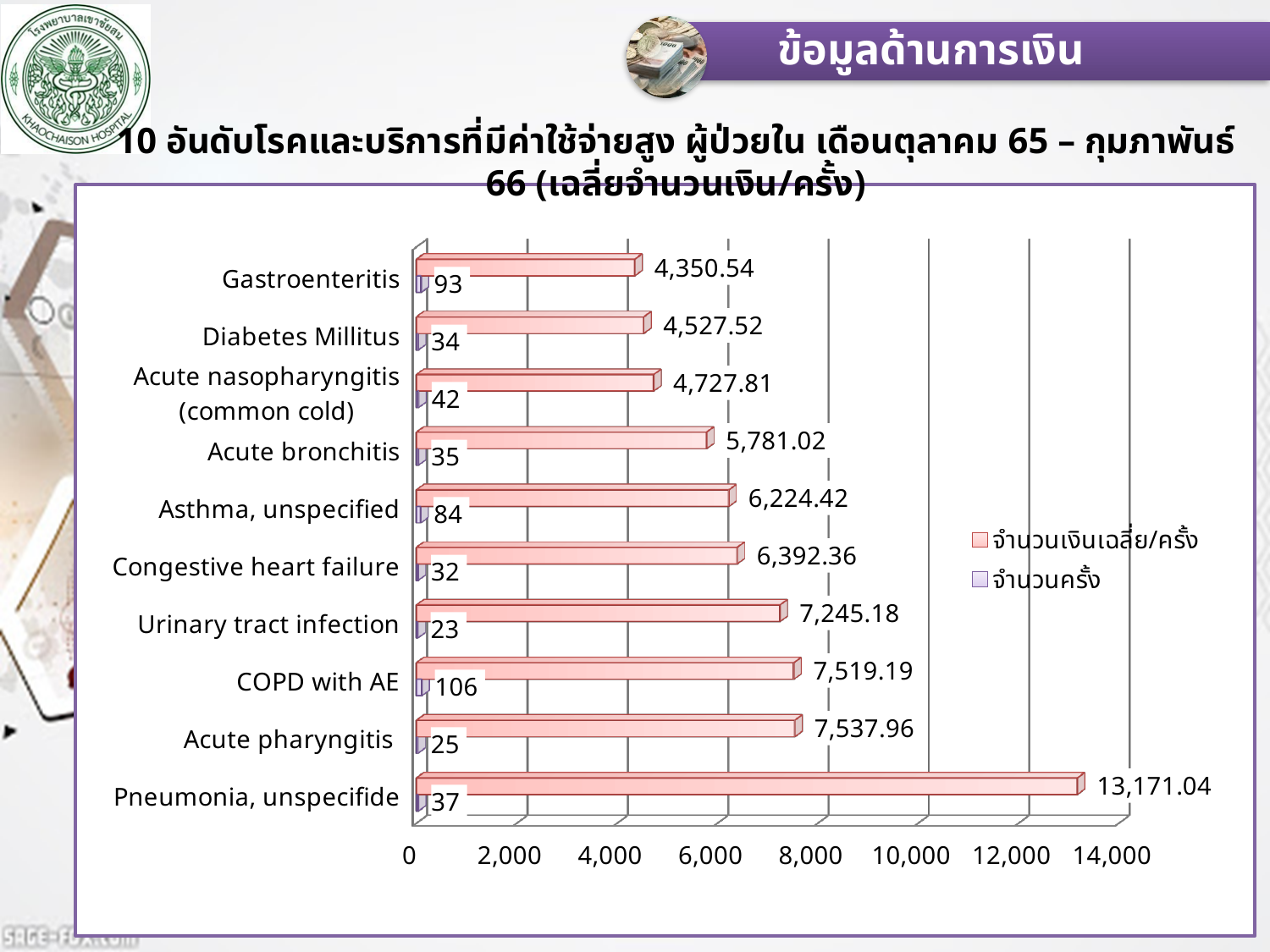
Which category has the highest average amount per visit? Pneumonia, unspecifide Which category has the lowest number of visits (จำนวนครั้ง)? Urinary tract infection Which has a higher average amount per visit, Asthma, unspecified or Acute bronchitis? Asthma, unspecified What is the number of visits (จำนวนครั้ง) for COPD with AE? 106 How many categories are shown in the chart? 10 Which category has the lowest average amount per visit? Gastroenteritis What is the difference between the average amount per visit for Acute pharyngitis and COPD with AE? 18.77 What is the average amount per visit (จำนวนเงินเฉลี่ย/ครั้ง) for Pneumonia, unspecifide? 13,171.04 What is the average amount per visit for Urinary tract infection? 7,245.18 How many series does the legend list? 2 What kind of chart is shown on the slide? bar chart Is the average amount per visit for Congestive heart failure greater or less than 6,000? greater